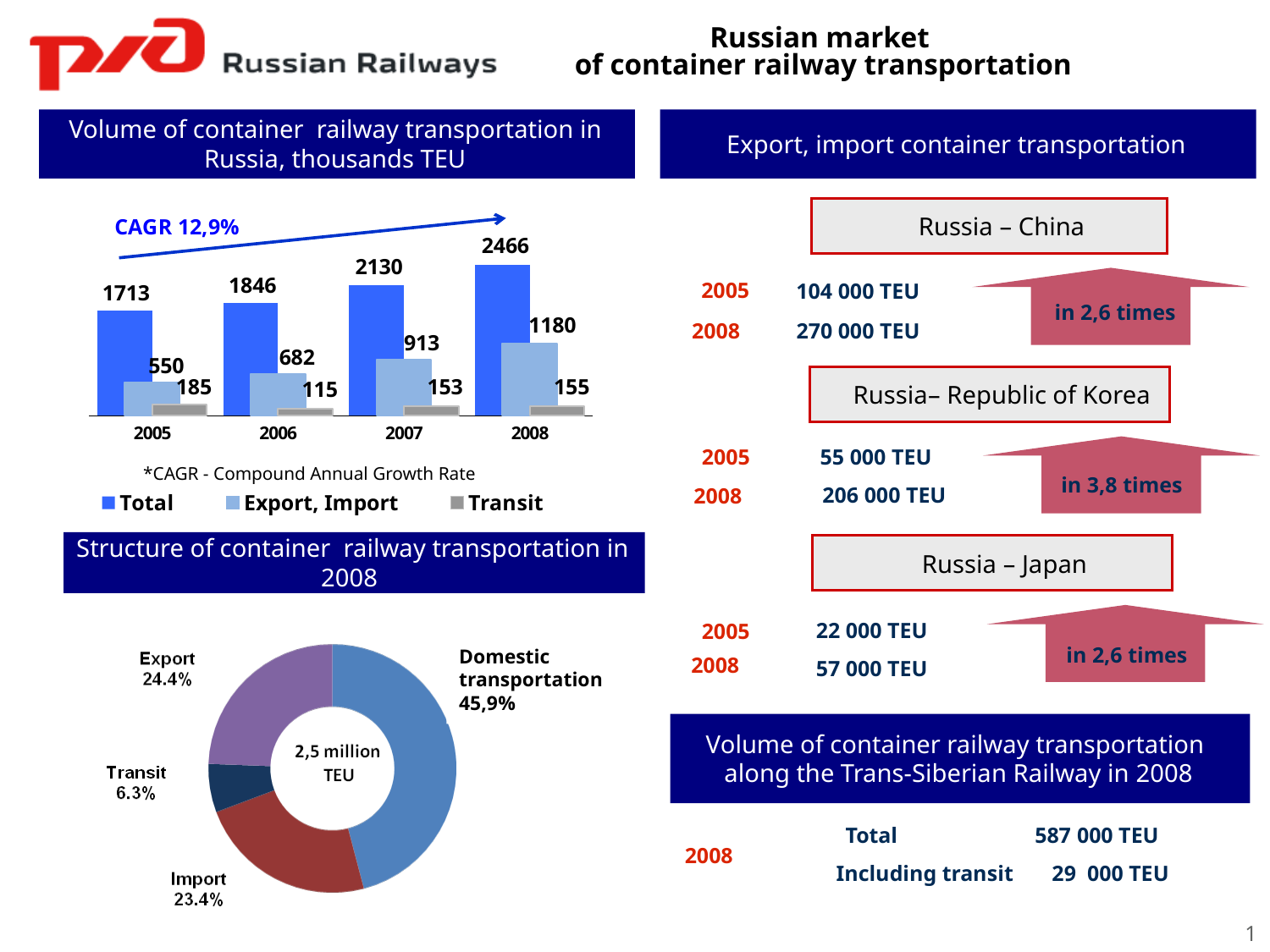
In the pie chart 'Structure of container railway transportation in 2008', what share does Domestic transportation have? 45,9% What kind of chart is used for 'Structure of container railway transportation in 2008'? pie chart In the bar chart 'Volume of container railway transportation in Russia, thousands TEU', is the Export, Import value for 2007 larger or smaller than the Export, Import value for 2008? smaller In the bar chart 'Volume of container railway transportation in Russia, thousands TEU', what is the Total value for 2008? 2466 In the bar chart 'Volume of container railway transportation in Russia, thousands TEU', which year has the lowest Total value? 2005 In the bar chart 'Volume of container railway transportation in Russia, thousands TEU', how many years are shown on the x axis? 4 In the bar chart 'Volume of container railway transportation in Russia, thousands TEU', what is the difference between the Total values for 2008 and 2007? 336 In the bar chart 'Volume of container railway transportation in Russia, thousands TEU', does the Total series rise or fall from 2005 to 2008? rise In the bar chart 'Volume of container railway transportation in Russia, thousands TEU', what is the Export, Import value for 2006? 682 In the bar chart 'Volume of container railway transportation in Russia, thousands TEU', which year has the highest Transit value? 2005 In the pie chart 'Structure of container railway transportation in 2008', which segment is the smallest? Transit In the bar chart 'Volume of container railway transportation in Russia, thousands TEU', how many series does the legend list? 3